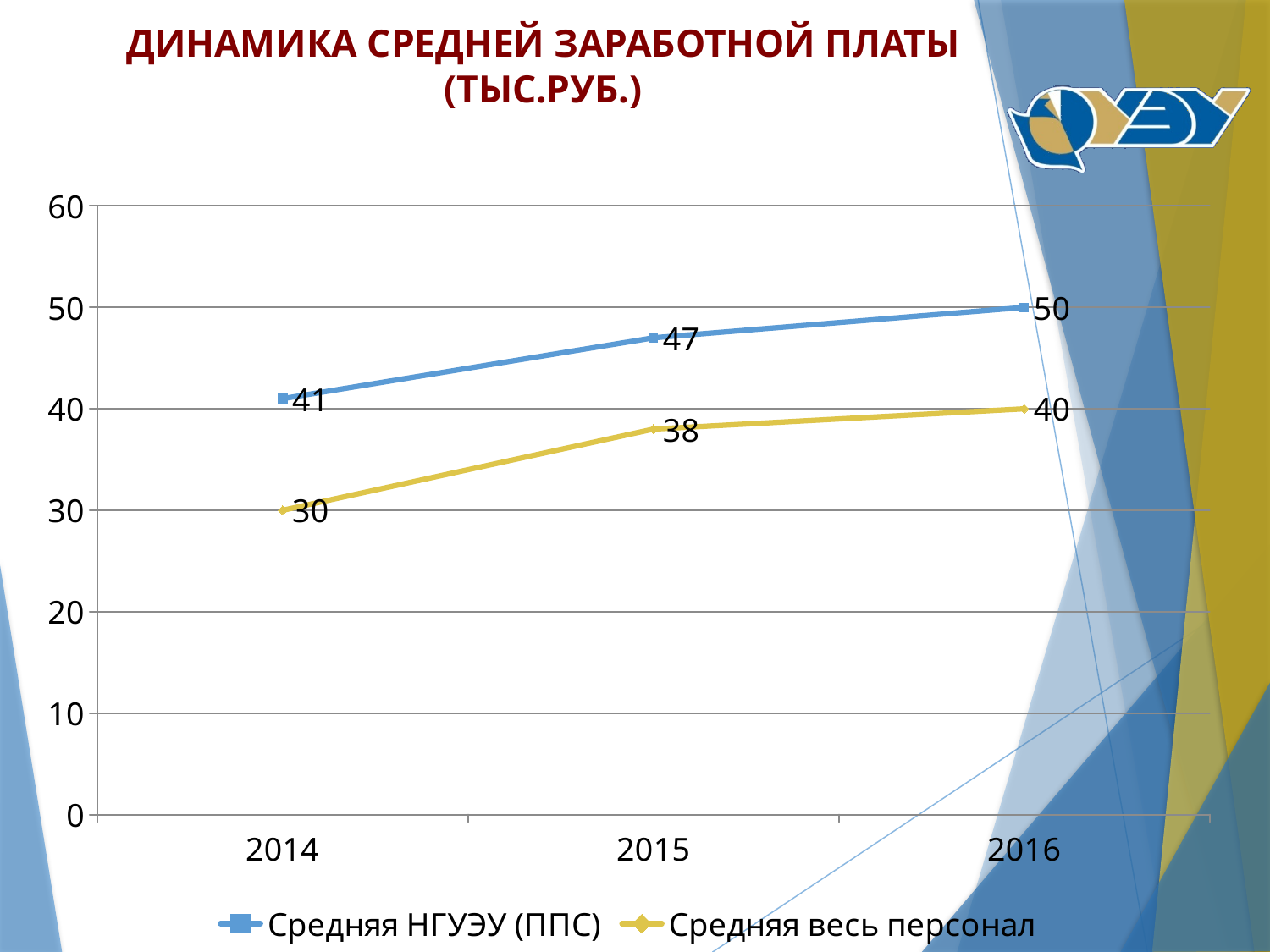
Do the values for Средняя весь персонал rise or fall from 2014 to 2016? rise What is the difference between Средняя НГУЭУ (ППС) and Средняя весь персонал in 2016? 10 In which year is the value for Средняя НГУЭУ (ППС) highest? 2016 What is the value for Средняя НГУЭУ (ППС) in 2014? 41 In which year is the value for Средняя весь персонал lowest? 2014 Which series has the larger value in 2015, Средняя НГУЭУ (ППС) or Средняя весь персонал? Средняя НГУЭУ (ППС) What type of chart is shown on the slide? line chart How many years are shown on the x axis? 3 What is the value for Средняя НГУЭУ (ППС) in 2016? 50 What is the value for Средняя весь персонал in 2015? 38 What is the value for Средняя весь персонал in 2014? 30 How many series does the legend list? 2